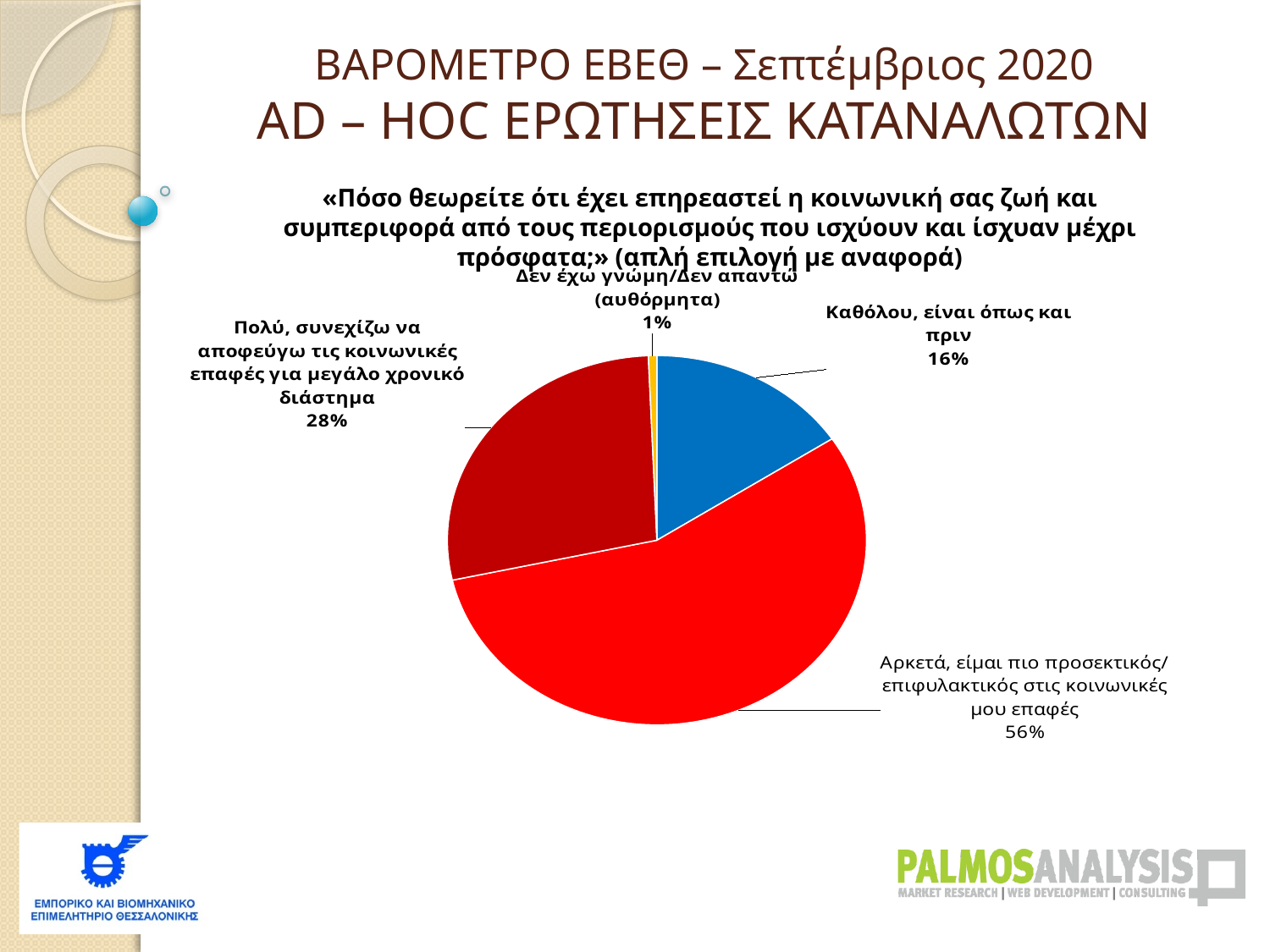
What is the difference in percentage points between the «Πολύ» slice (28%) and the «Καθόλου» slice (16%)? 12 What share of respondents answered «Αρκετά, είμαι πιο προσεκτικός/επιφυλακτικός στις κοινωνικές μου επαφές»? 56% How many percentage points larger is the «Αρκετά» slice than the «Πολύ» slice? 28 What share of respondents answered «Καθόλου, είναι όπως και πριν»? 16% What share of respondents answered «Πολύ, συνεχίζω να αποφεύγω τις κοινωνικές επαφές για μεγάλο χρονικό διάστημα»? 28% How many slices does the pie chart have? 4 Which answer has the largest slice of the pie? Αρκετά, είμαι πιο προσεκτικός/επιφυλακτικός στις κοινωνικές μου επαφές What share of respondents answered «Δεν έχω γνώμη/Δεν απαντώ (αυθόρμητα)»? 1% Which answer has the smallest slice of the pie? Δεν έχω γνώμη/Δεν απαντώ (αυθόρμητα) What kind of chart is shown on the slide? pie chart What colour is the slice for «Καθόλου, είναι όπως και πριν»? blue Which is larger: the share for «Καθόλου, είναι όπως και πριν» or the share for «Πολύ, συνεχίζω να αποφεύγω τις κοινωνικές επαφές»? Πολύ, συνεχίζω να αποφεύγω τις κοινωνικές επαφές